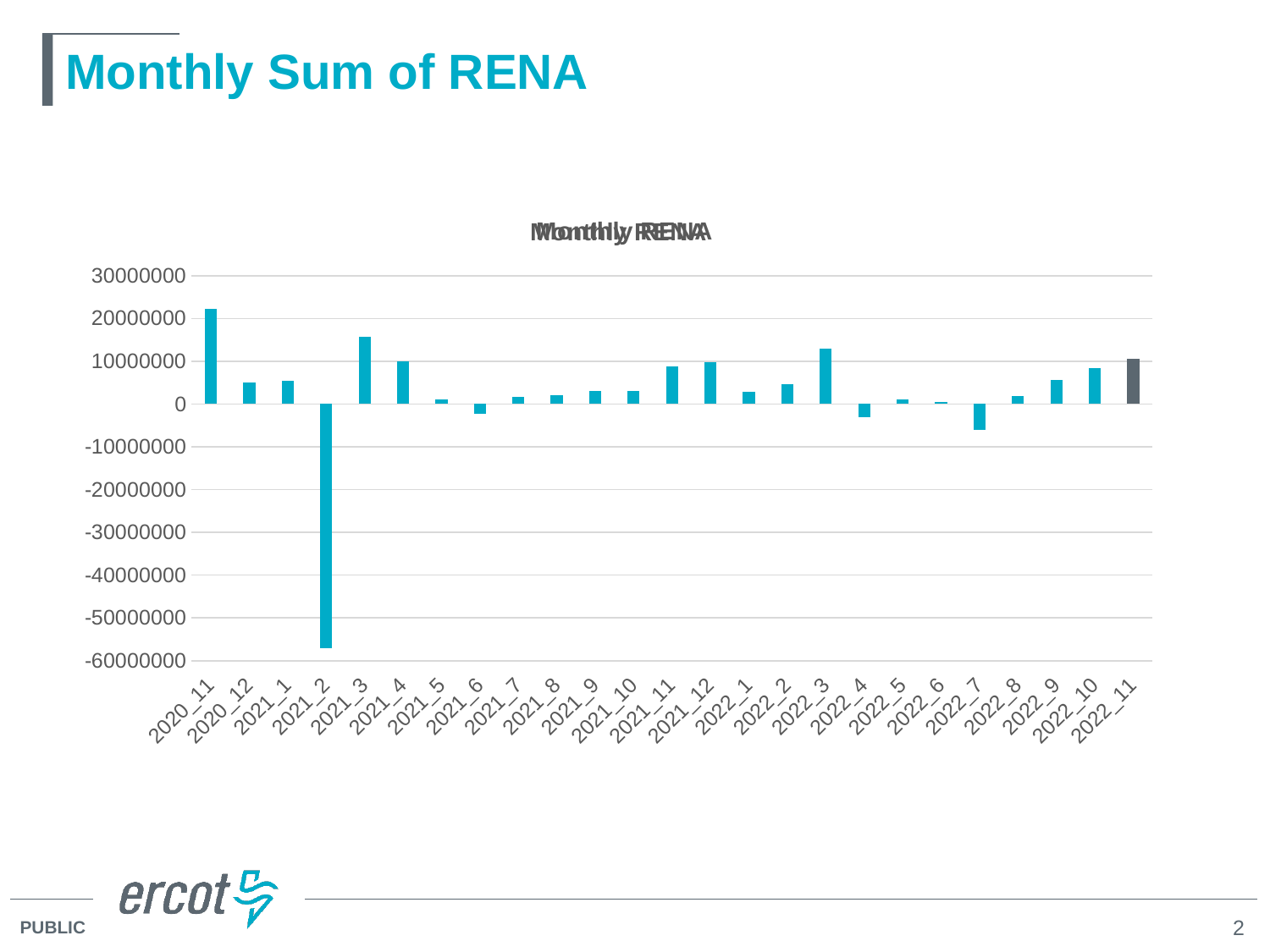
Which is larger, the value for 2021_3 or the value for 2021_4? 2021_3 Which month has the lowest value? 2021_2 Which month's bar is drawn in a different (dark grey) colour from the rest? 2022_11 Is the value for 2022_7 greater or less than 0? less Is the value for 2021_2 greater or less than -50000000? less Is the value for 2021_3 greater or less than 10000000? greater What kind of chart is shown on the slide? bar chart Which month has the highest value? 2020_11 Which is larger, the value for 2022_10 or the value for 2022_5? 2022_10 How many months (categories) are plotted on the x axis? 25